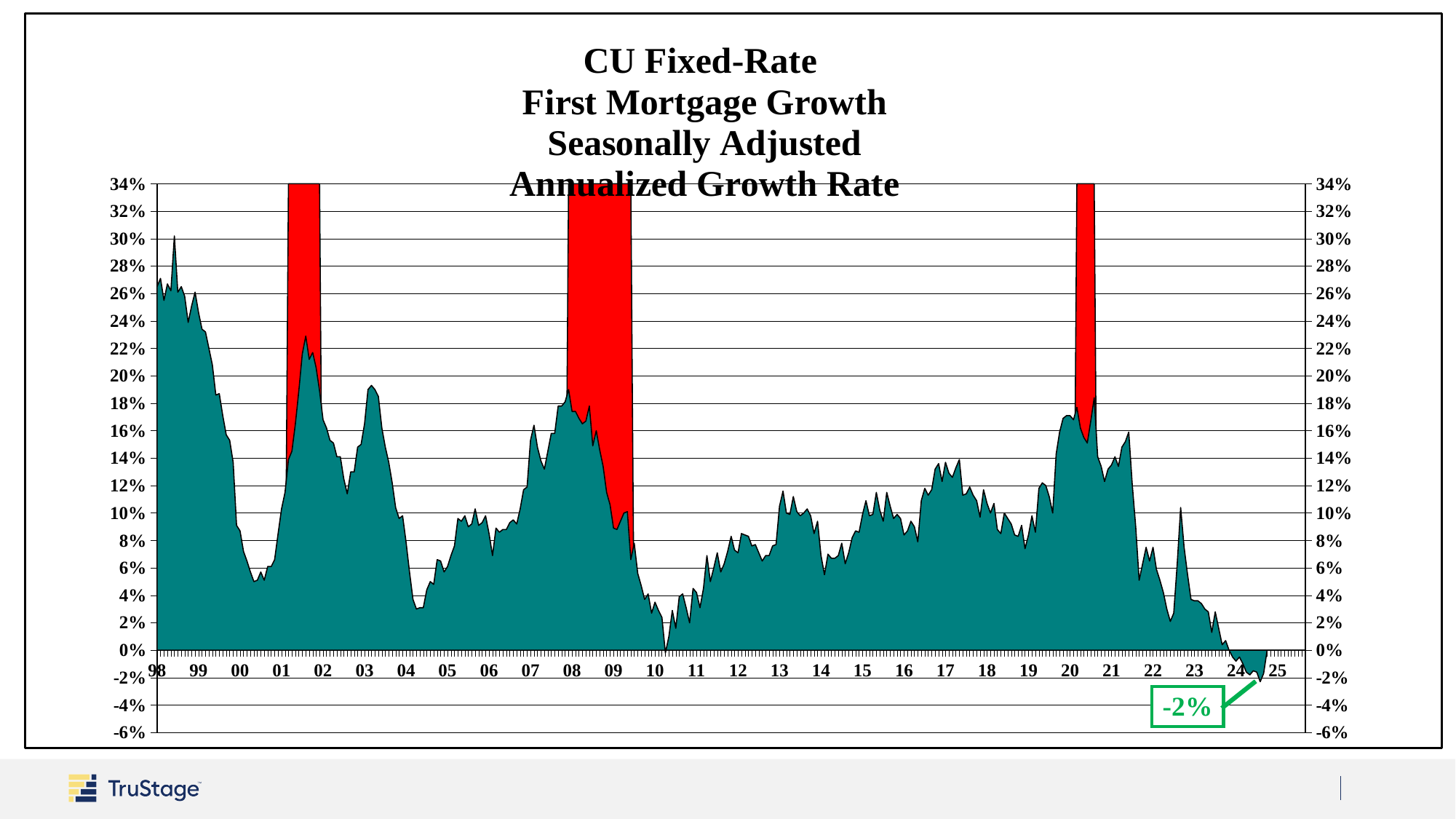
Between 2022 and 2025, do the values generally rise or fall? Fall What is the highest value shown on the y-axis? 34% Is the value in 2020 greater or less than 14%? greater Which year has the larger growth rate, 1999 or 2010? 1999 What kind of chart is shown on the slide? Area chart What is the labeled value at the end of the series in 2025? -2% What is the first year shown on the x-axis? 98 What is the lowest value shown on the y-axis? -6% How many red shaded regions are marked on the chart? 3 Is the value at the start of 1998 greater or less than 20%? greater Is the value in 2016 greater or less than 4%? greater